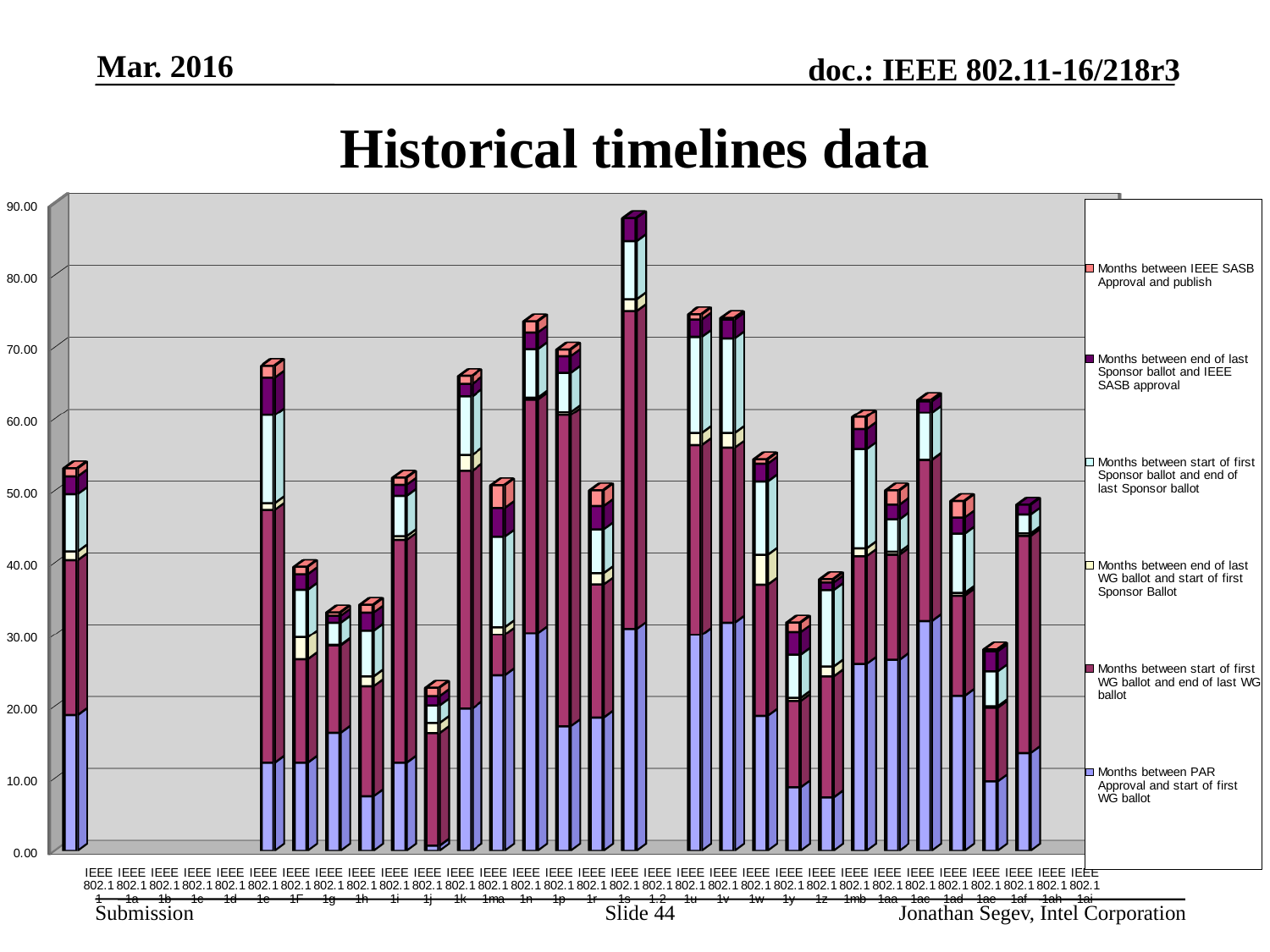
What kind of chart is shown on the slide? stacked bar chart Is the total of the first stacked bar (IEEE 802.11) greater or less than 50? greater Is the total of the shortest stacked bar greater or less than 30? less How many series does the legend list? 6 Is the total of the tallest stacked bar greater or less than 80? greater What is the title of the chart? Historical timelines data Which series is shown at the bottom of each stacked bar, according to the legend? Months between PAR Approval and start of first WG ballot